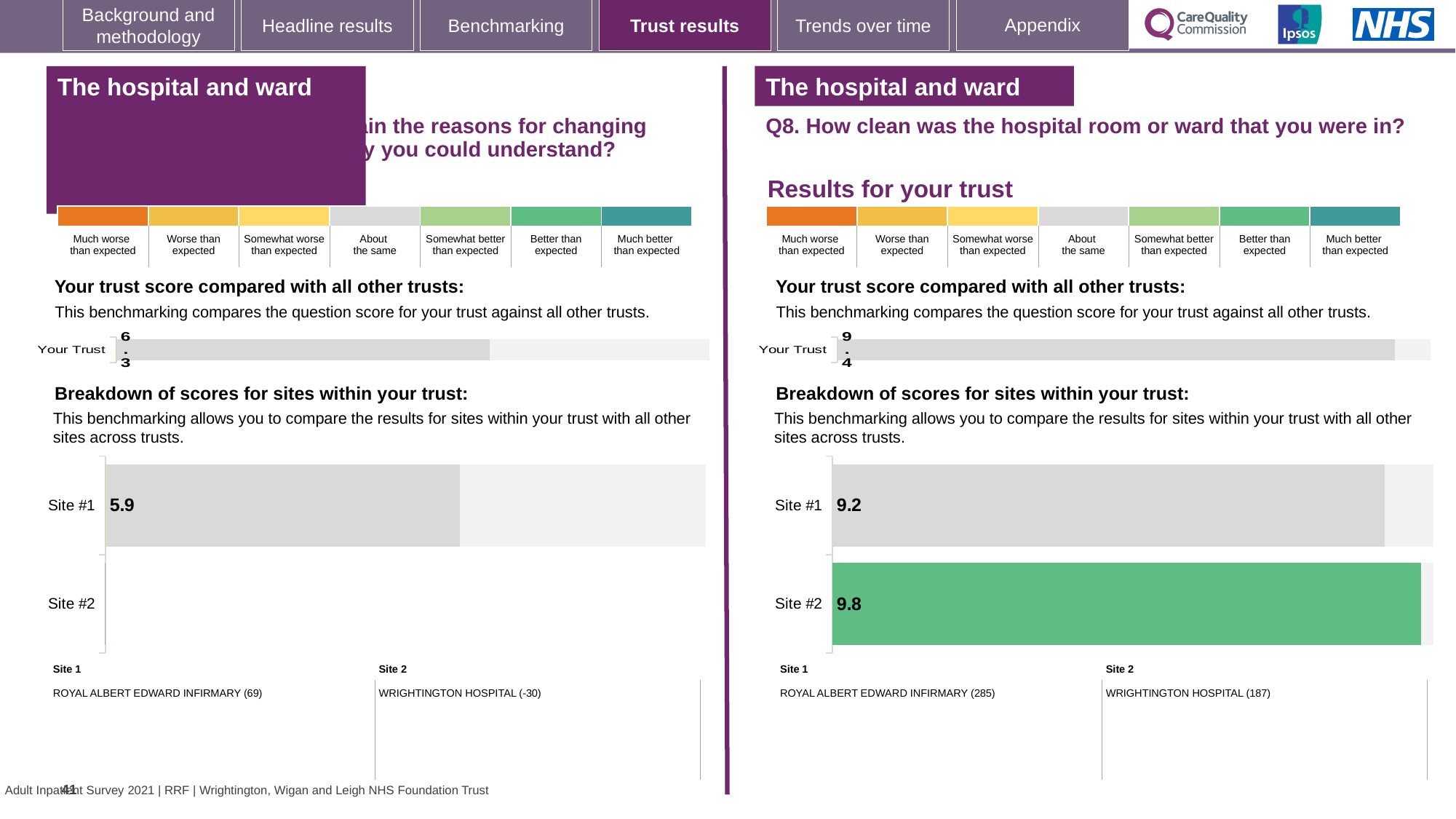
On the right-hand chart (Q8), which site's bar is coloured green? Site #2 On the right-hand chart (Q8, how clean was the hospital room or ward), what is the score for Site #2? 9.8 What kind of chart is used for the breakdown of scores for sites on the right-hand side of the slide? bar chart How many sites are listed in the site breakdown on the right-hand chart (Q8)? 2 On the right-hand chart (Q8), what is the difference between the Site #2 and Site #1 scores? 0.6 On the right-hand chart (Q8), what is the 'Your Trust' score compared with all other trusts? 9.4 On the left-hand chart, what is the 'Your Trust' score compared with all other trusts? 6.3 On the right-hand chart (Q8), which site has the higher score? Site #2 On the left-hand chart, what is the score for Site #1? 5.9 On the right-hand side of the slide, which hospital is listed as Site 2? WRIGHTINGTON HOSPITAL (187) On the right-hand chart (Q8, how clean was the hospital room or ward), what is the score for Site #1? 9.2 On the right-hand chart (Q8), is the Site #1 score larger or smaller than the Site #2 score? smaller